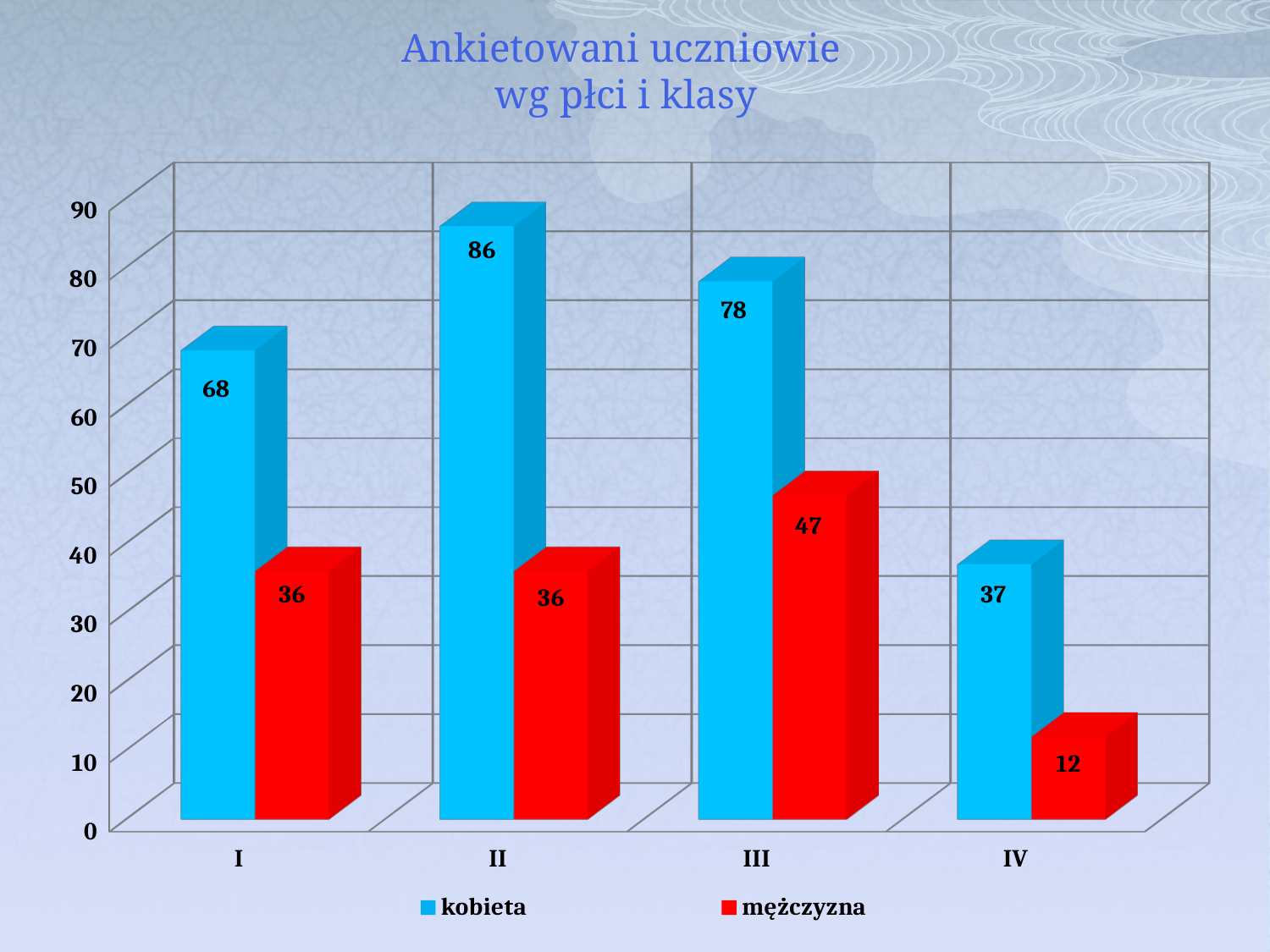
What is the total of kobieta and mężczyzna in class IV? 49 What is the value for kobieta in class II? 86 What kind of chart is shown on the slide? bar chart How many classes are shown on the x axis? 4 What is the title of the chart? Ankietowani uczniowie wg płci i klasy How many series does the legend list? 2 What is the difference between kobieta and mężczyzna in class I? 32 Which class has the highest value for kobieta? II What is the value for mężczyzna in class III? 47 Which class has the lowest value for mężczyzna? IV What is the value for mężczyzna in class IV? 12 Which is larger in class III, kobieta or mężczyzna? kobieta